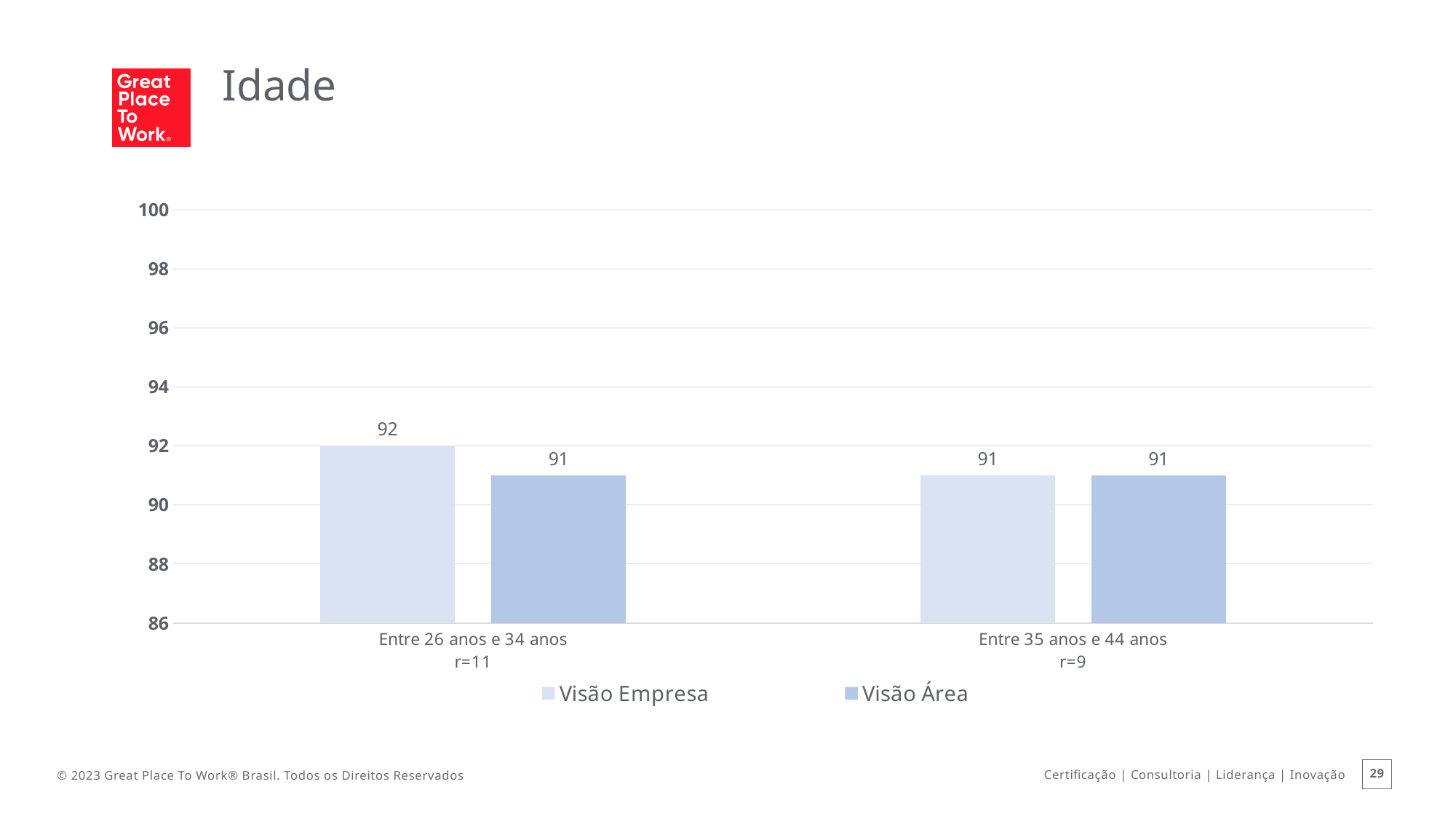
What is the Visão Empresa value for 'Entre 26 anos e 34 anos'? 92 What is the Visão Área value for 'Entre 26 anos e 34 anos'? 91 Is the Visão Área value for 'Entre 35 anos e 44 anos' greater or less than 90? greater What is the Visão Empresa value for 'Entre 35 anos e 44 anos'? 91 For 'Entre 26 anos e 34 anos', which is larger: Visão Empresa or Visão Área? Visão Empresa What is the Visão Área value for 'Entre 35 anos e 44 anos'? 91 What kind of chart is shown on the slide? Bar chart What is the title of the slide? Idade How many age categories are shown on the x axis? 2 How many series does the legend list? 2 Which category has the highest Visão Empresa value? Entre 26 anos e 34 anos What is the difference between the Visão Empresa and Visão Área values for 'Entre 26 anos e 34 anos'? 1